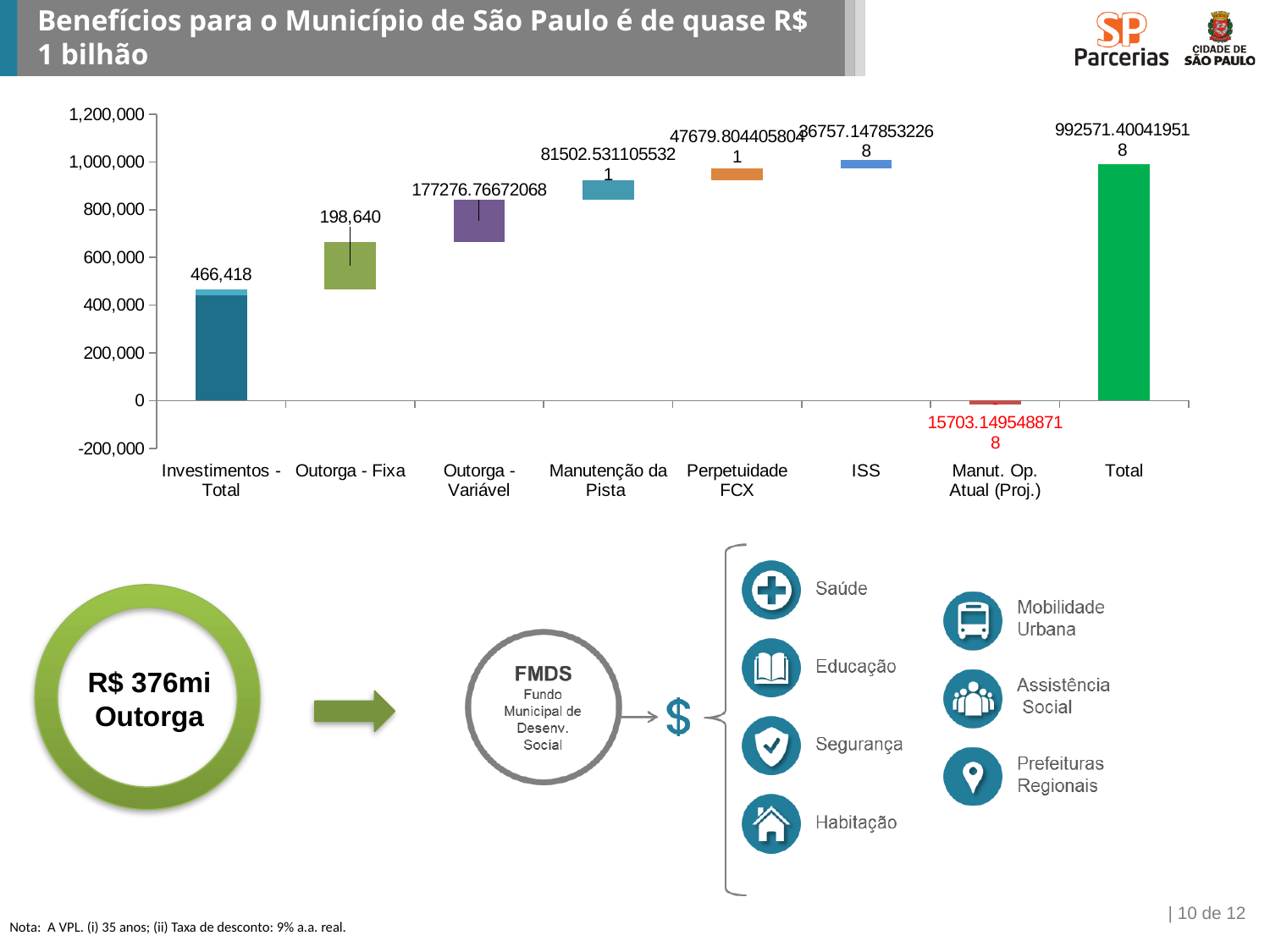
What is the difference between the values for Investimentos - Total and Outorga - Fixa? 267,778 What is the value shown for Outorga - Fixa? 198,640 What kind of chart is shown on the slide? bar chart Is the value for Investimentos - Total greater or less than 400,000? greater Is the value for Total greater or less than 1,000,000? less What colour is the bar for Total? green What is the title of the slide containing the chart? Benefícios para o Município de São Paulo é de quase R$ 1 bilhão Which category has the lowest value in the chart? Manut. Op. Atual (Proj.) What is the value shown for Investimentos - Total? 466,418 Which category has the highest value in the chart? Total Which is larger, the value for Investimentos - Total or the value for Outorga - Fixa? Investimentos - Total How many categories are shown on the x axis of the chart? 8